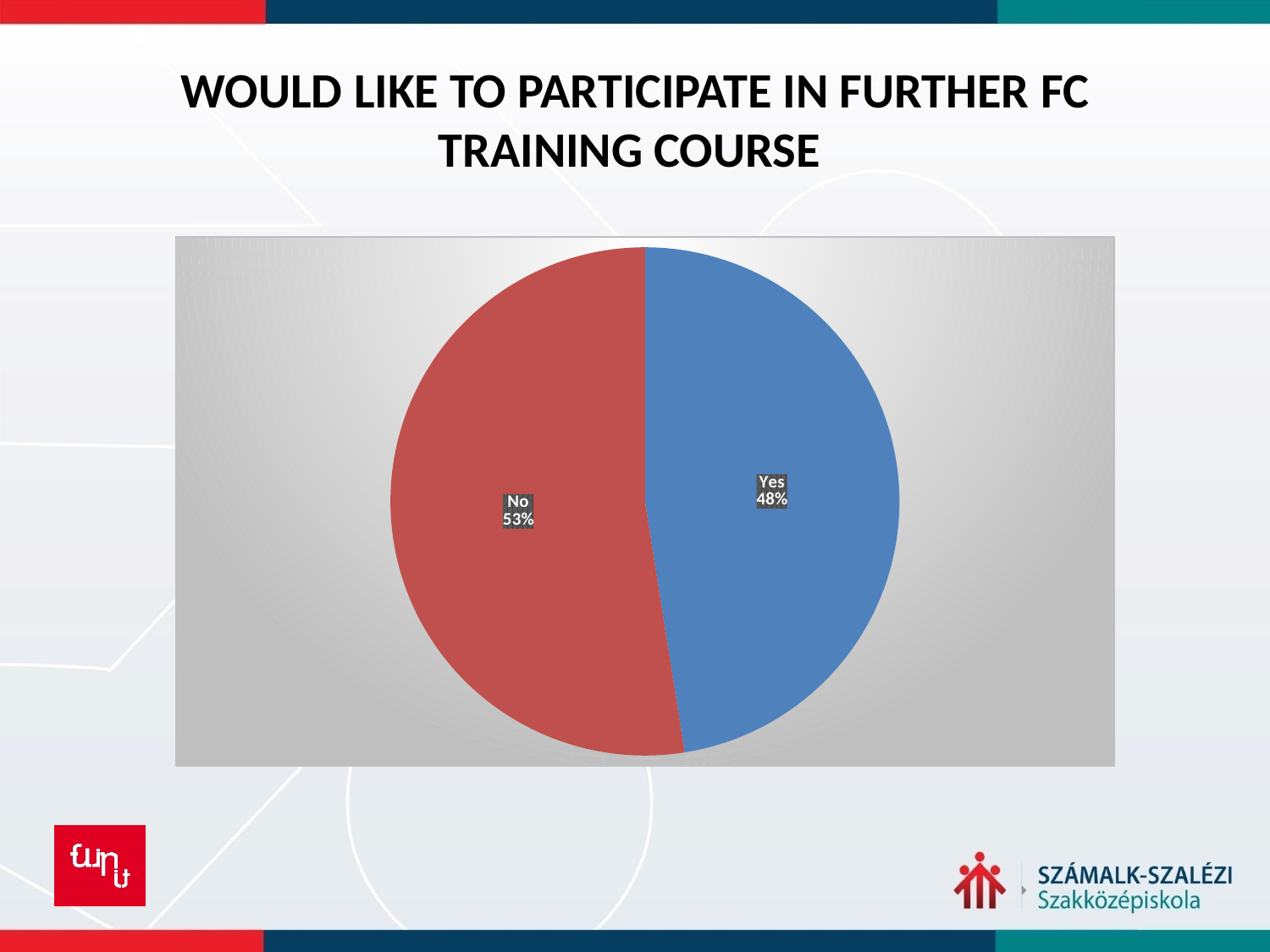
Which slice is the largest? No What share of the pie is labelled "Yes"? 48% Which slice is the smallest? Yes What kind of chart is shown on the slide? pie chart How many slices does the pie chart have? 2 Which is larger, the "Yes" slice or the "No" slice? No What share of the pie is labelled "No"? 53% Is the share for "Yes" greater or less than 50%? less Is the share for "No" greater or less than 50%? greater What is the difference in percentage points between the "No" and "Yes" slices? 5% What colour is the "Yes" slice? blue What is the title of the slide containing the chart? WOULD LIKE TO PARTICIPATE IN FURTHER FC TRAINING COURSE